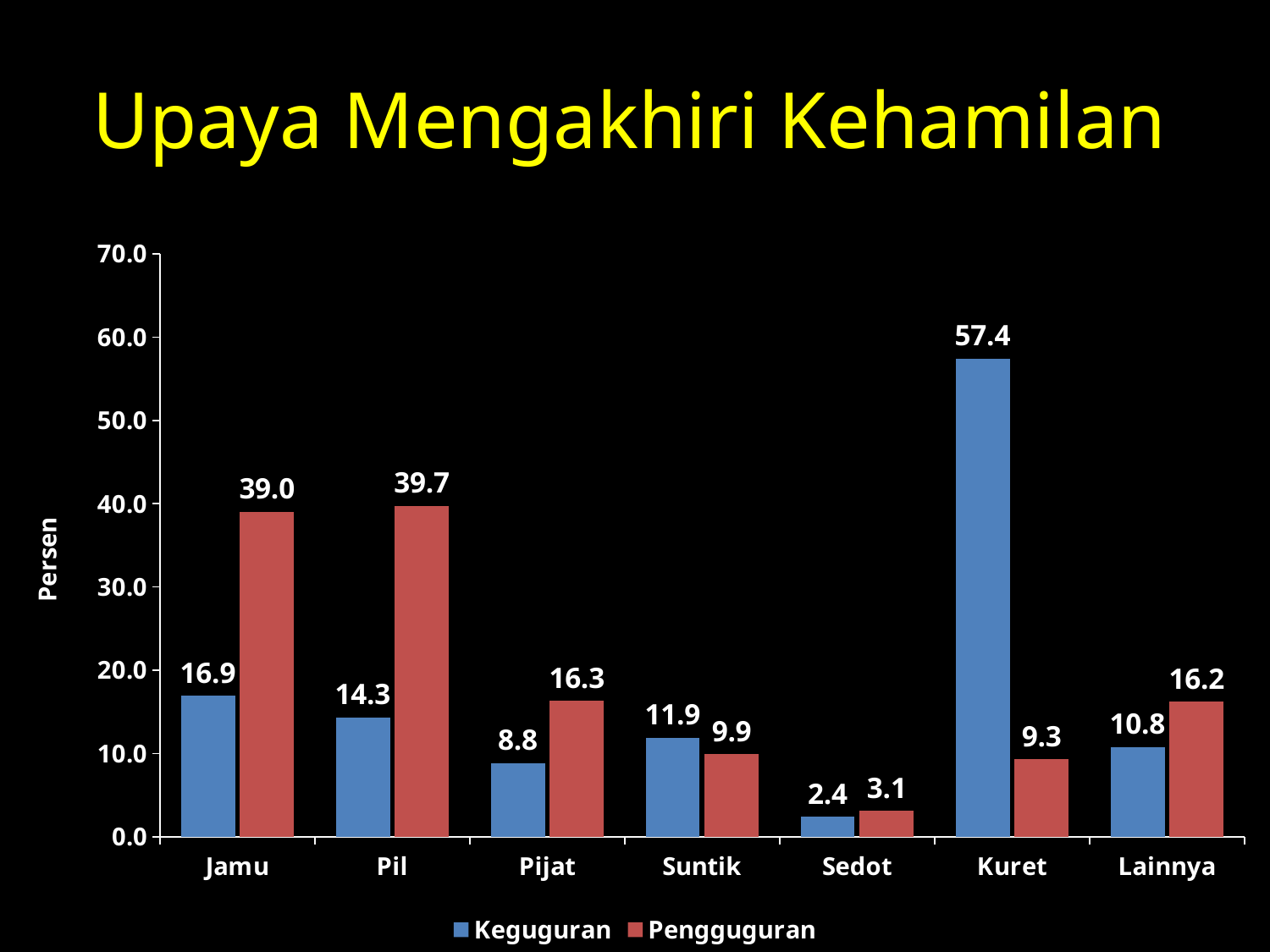
Which is larger for Suntik, Kegugguran or Penggugguran? Kegugguran How many series does the legend list? 2 What is the Kegugguran value for Kuret? 57.4 What is the label of the y axis? Persen Is the Kegugguran value for Kuret greater or less than 50.0? greater What is the Penggugguran value for Pil? 39.7 What kind of chart is shown on the slide? bar chart What is the difference between the Penggugguran and Kegugguran values for Jamu? 22.1 How many categories are shown on the x axis? 7 Which category has the lowest Kegugguran value? Sedot Which category has the highest Penggugguran value? Pil What is the Kegugguran value for Jamu? 16.9